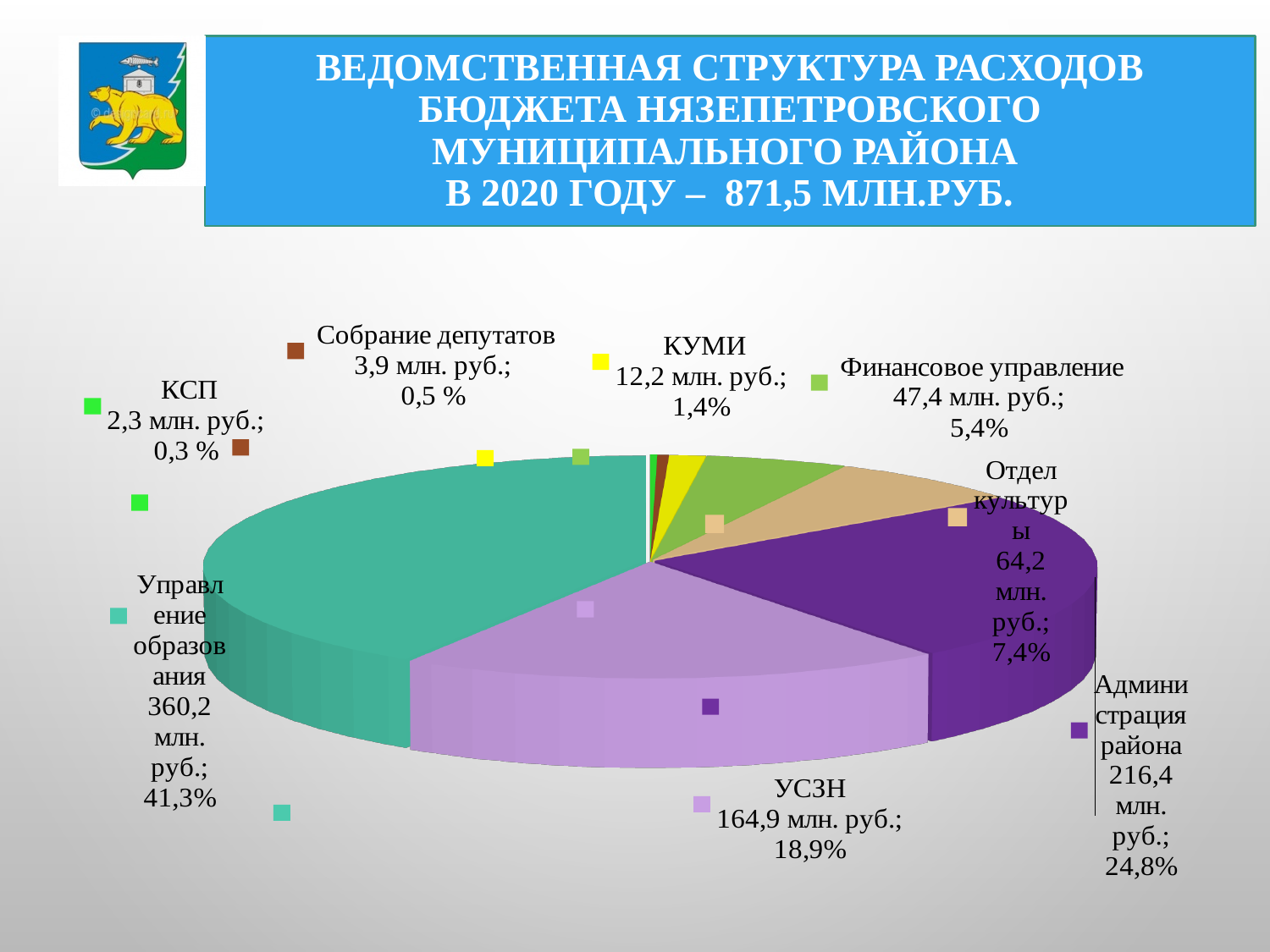
What is the value for Собрание депутатов? 3,9 млн. руб. What share of the pie does Финансовое управление have? 5,4% What is the difference in млн. руб. between Администрация района and УСЗН? 51,5 млн. руб. What kind of chart is shown on the slide? Pie chart What total amount in млн. руб. is stated in the chart title for 2020? 871,5 млн.руб. How many categories does the pie chart show? 8 What is the value for УСЗН? 164,9 млн. руб. What share of the pie does Администрация района have? 24,8% What is the value for Управление образования? 360,2 млн. руб. Which category has the smallest share of the pie? КСП Which category has the largest share of the pie? Управление образования Which is larger, Отдел культуры or КУМИ? Отдел культуры